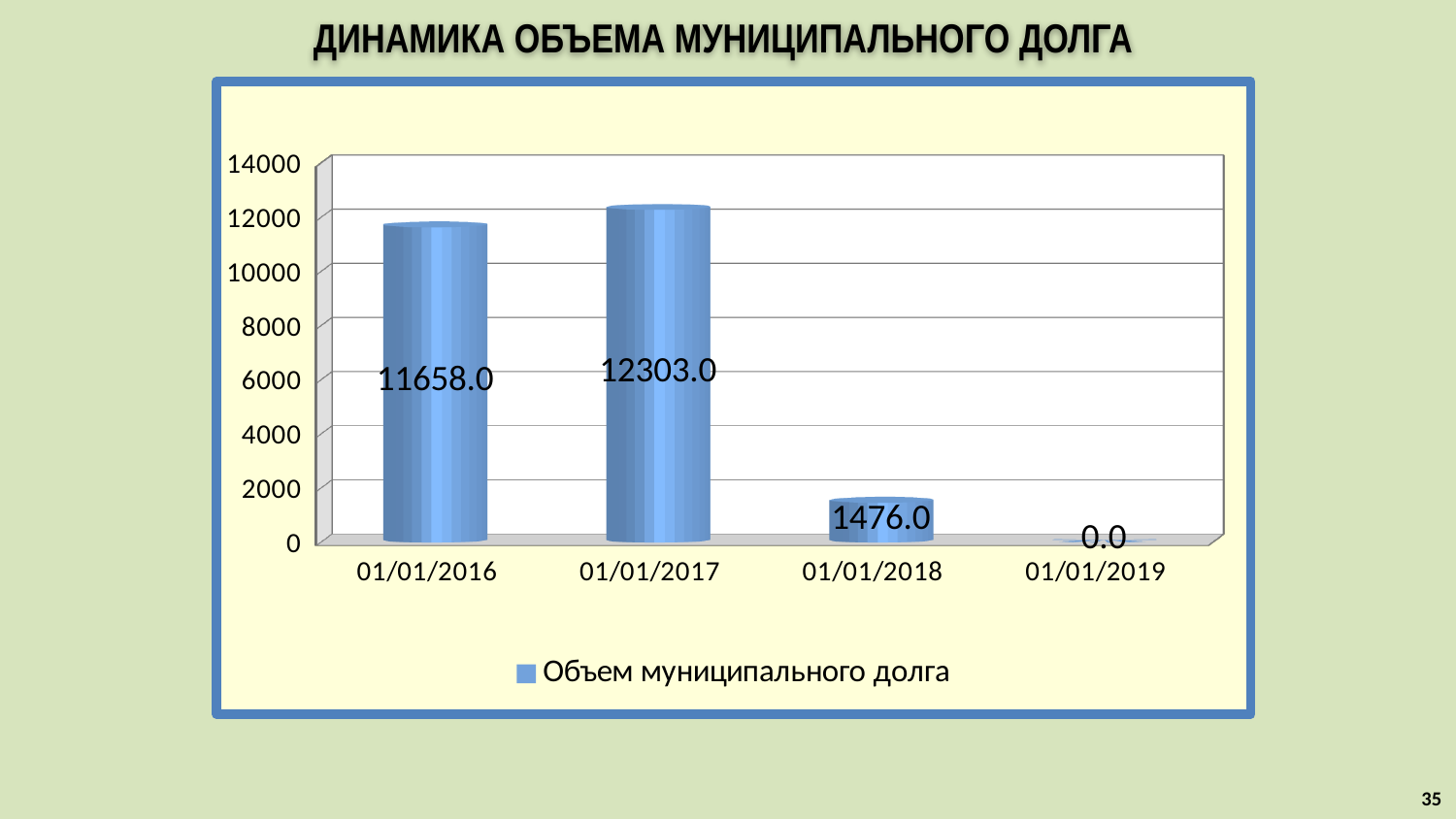
What series does the legend list? Объем муниципального долга Which is larger, the value for 01/01/2016 or the value for 01/01/2018? 01/01/2016 What is the value for 01/01/2018? 1476.0 What is the value for 01/01/2016? 11658.0 Which date has the highest value? 01/01/2017 What is the value for 01/01/2019? 0.0 What is the difference between the values for 01/01/2017 and 01/01/2018? 10827.0 Which date has the lowest value? 01/01/2019 How many dates are shown on the x axis? 4 What is the difference between the values for 01/01/2017 and 01/01/2016? 645.0 What kind of chart is shown? bar chart What is the value for 01/01/2017? 12303.0